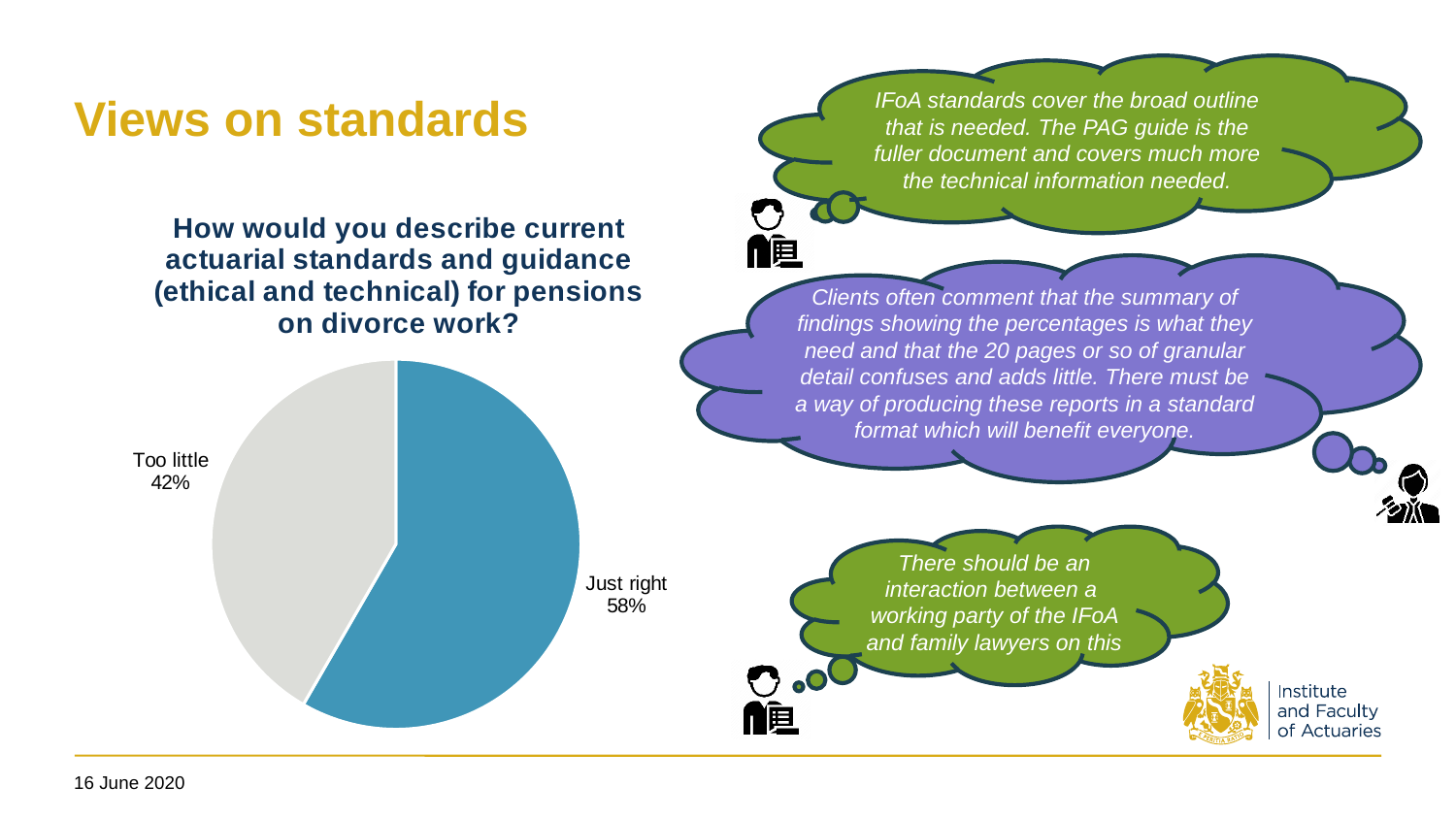
What question does the pie chart's title ask? How would you describe current actuarial standards and guidance (ethical and technical) for pensions on divorce work? What is the difference in percentage points between 'Just right' and 'Too little'? 16 What colour is the 'Just right' slice of the pie chart? blue What percentage of respondents said current actuarial standards and guidance are 'Too little'? 42% How many slices does the pie chart have? 2 What percentage of respondents said current actuarial standards and guidance are 'Just right'? 58% Which response has the smallest share of the pie? Too little What kind of chart is shown on the slide? pie chart Which is larger: the share for 'Just right' or the share for 'Too little'? Just right What share of the pie does the 'Too little' slice represent? 42% Which response has the largest share of the pie? Just right